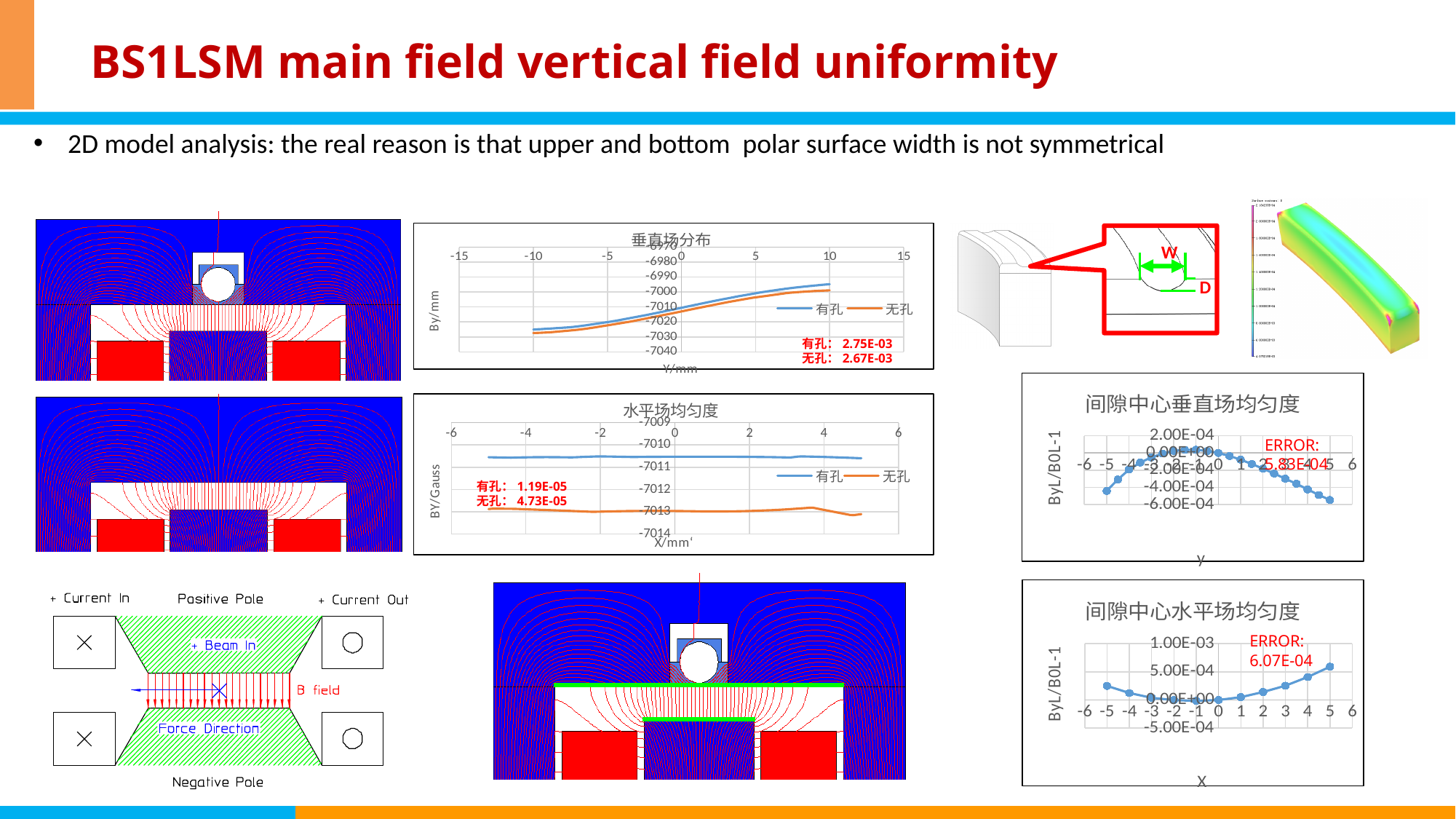
What is the title of the top middle chart with the blue and orange lines? 垂直场分布 In the chart titled 垂直场分布, which series has the higher values, 有孔 or 无孔? 有孔 In the chart titled 水平场均匀度, which series lies higher on the axis, 有孔 or 无孔? 有孔 In the chart titled 垂直场分布, do the values rise or fall as Y/mm increases from -10 to 10? rise What kind of chart is the one titled 水平场均匀度? line chart What ERROR value is printed on the chart titled 间隙中心垂直场均匀度? 5.83E-04 In the chart titled 水平场均匀度, what value is printed in red for 无孔? 4.73E-05 In the chart titled 垂直场分布, how many series does the legend list? 2 In the chart titled 水平场均匀度, is the 无孔 value at X/mm = 0 greater or less than -7012? less In the chart titled 垂直场分布, what value is printed in red for 有孔? 2.75E-03 In the chart titled 间隙中心水平场均匀度, is the value at x = 5 greater or less than 5.00E-04? greater In the chart titled 垂直场分布, is the 有孔 value at Y/mm = -10 greater or less than -7010? less